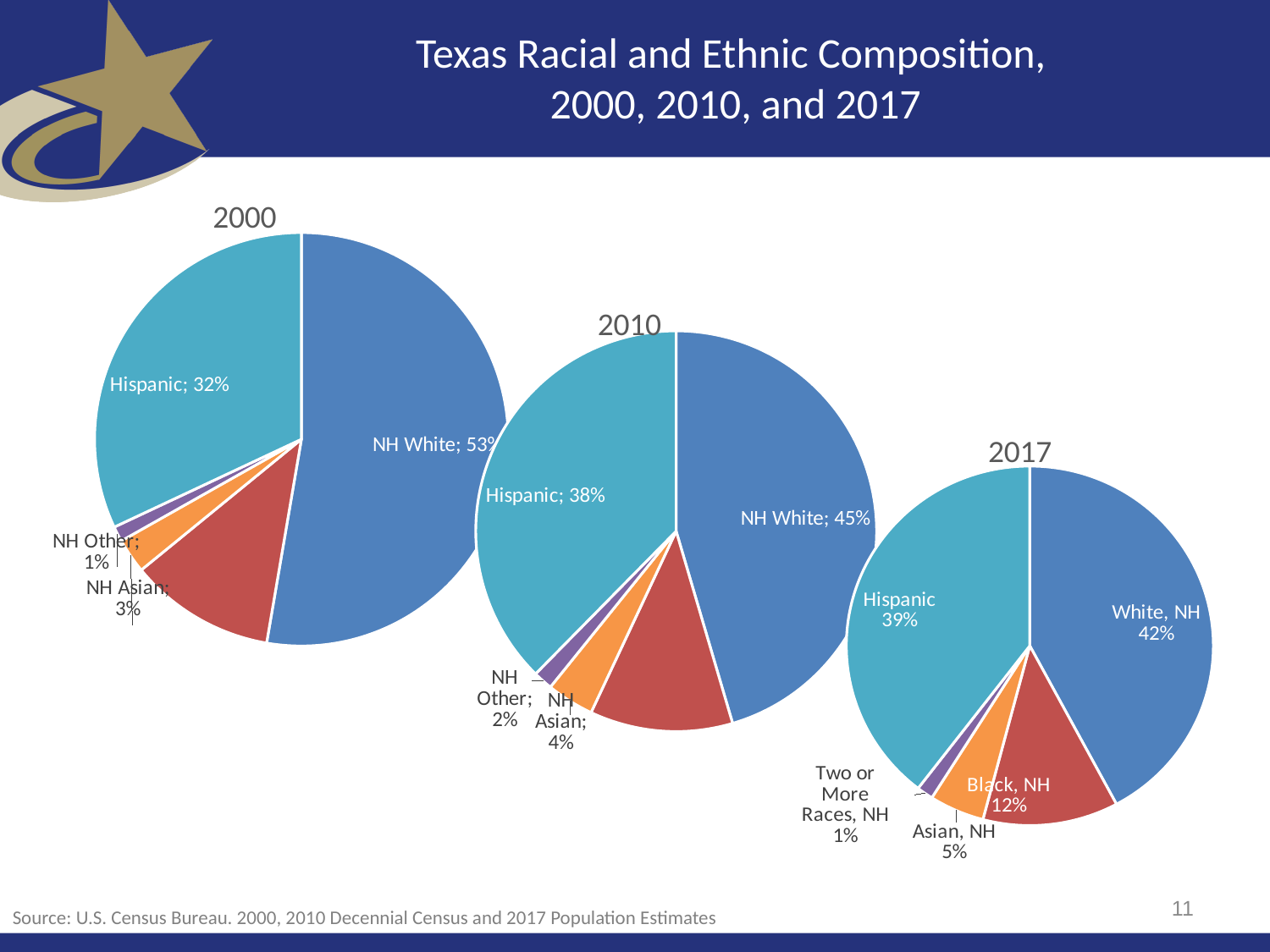
In the 2010 pie chart, which labeled group has the smallest share? NH Other How many slices does the 2017 pie chart have? 5 In the 2017 pie chart, what share is labeled for Black, NH? 12% In the 2000 pie chart, what share is labeled for Hispanic? 32% In the 2000 pie chart, what share is labeled for NH White? 53% In the 2017 pie chart, which is larger: the Hispanic share or the White, NH share? White, NH In the 2017 pie chart, which labeled group has the largest share? White, NH What kind of charts are shown on the slide? pie charts Across the 2000, 2010, and 2017 pie charts, does the NH White share rise or fall over time? fall In the 2017 pie chart, what share is labeled for Two or More Races, NH? 1% In the 2010 pie chart, what is the difference between the NH White share and the Hispanic share? 7% In the 2010 pie chart, what share is labeled for NH Asian? 4%